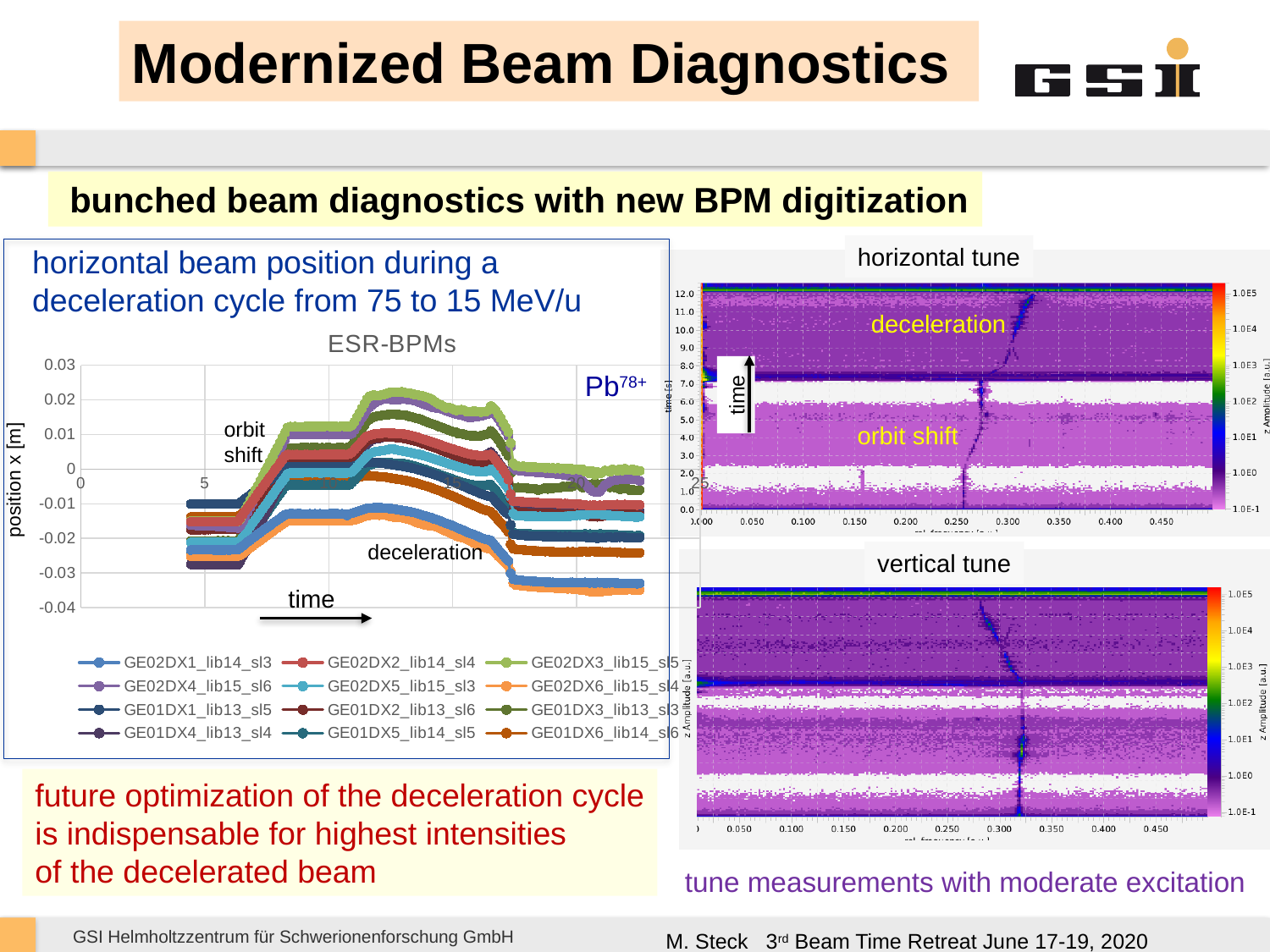
Which series is listed first in the legend of the ESR-BPMs chart? GE02DX1_lib14_sl3 In the ESR-BPMs chart, what is the highest value shown on the y axis? 0.03 What is the y-axis label of the ESR-BPMs chart? position x [m] In the ESR-BPMs chart, do the positions rise or fall during the section labelled 'deceleration'? fall How many series does the legend of the ESR-BPMs chart list? 12 What are the titles of the two tune plots on the right of the slide? horizontal tune and vertical tune In the ESR-BPMs chart, is the final value of the lowest series (GE02DX6_lib15_sl4) greater or less than -0.03? less In the ESR-BPMs chart, is the peak value of the topmost series (GE02DX3_lib15_sl5) greater or less than 0.02? greater What kind of chart is the ESR-BPMs chart on the left of the slide? line chart In the ESR-BPMs chart, what is the lowest value shown on the y axis? -0.04 In the ESR-BPMs chart, do the positions rise or fall during the section labelled 'orbit shift'? rise What is the title of the line chart on the left of the slide? ESR-BPMs